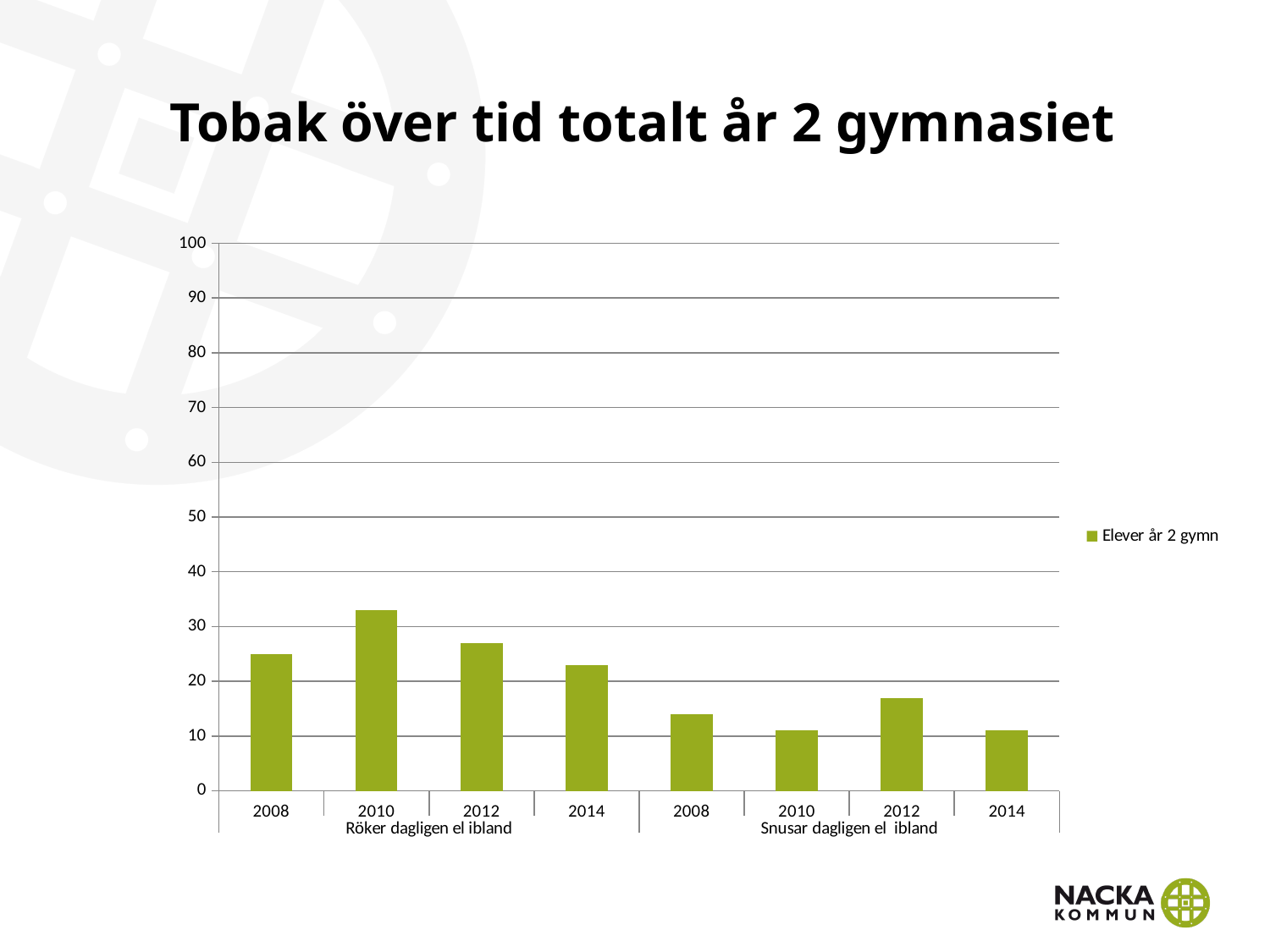
How many series does the legend list? 1 Is the value for 2010 under Snusar dagligen el ibland greater or less than 20? less How many bars are plotted in the chart? 8 Which is larger: the value for 2010 or the value for 2014 under Röker dagligen el ibland? 2010 Is the value for 2010 under Röker dagligen el ibland greater or less than 30? greater What kind of chart is shown on the slide? Bar chart Is the value for 2012 under Snusar dagligen el ibland greater or less than 20? less What is the name of the series in the legend? Elever år 2 gymn Do the values for Röker dagligen el ibland rise or fall from 2010 to 2014? fall What is the title of the chart? Tobak över tid totalt år 2 gymnasiet Which bar is the highest in the chart? 2010 under Röker dagligen el ibland